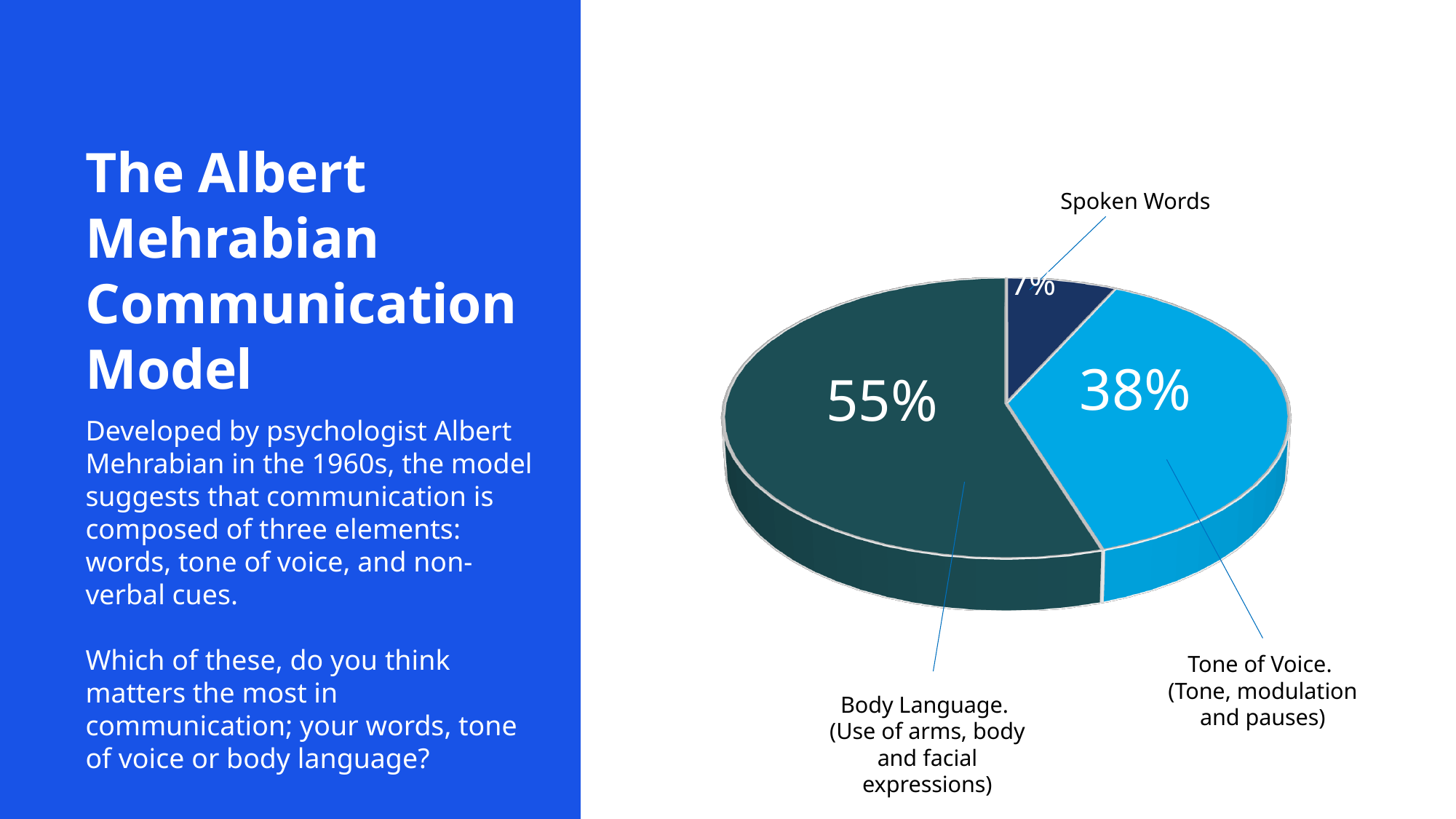
What share of the pie does the Body Language slice represent? 55% Which slice of the pie is the smallest? Spoken Words What percentage does the Body Language slice show? 55% What is the difference in percentage points between Tone of Voice and Spoken Words? 31 What percentage does the Spoken Words slice show? 7% What kind of chart is shown on the slide? pie chart How many slices does the pie chart have? 3 Which slice of the pie is the largest? Body Language Which is larger, the Tone of Voice slice or the Spoken Words slice? Tone of Voice What percentage does the Tone of Voice slice show? 38% What is the difference in percentage points between Body Language and Tone of Voice? 17 What colour is the Spoken Words slice? dark navy blue